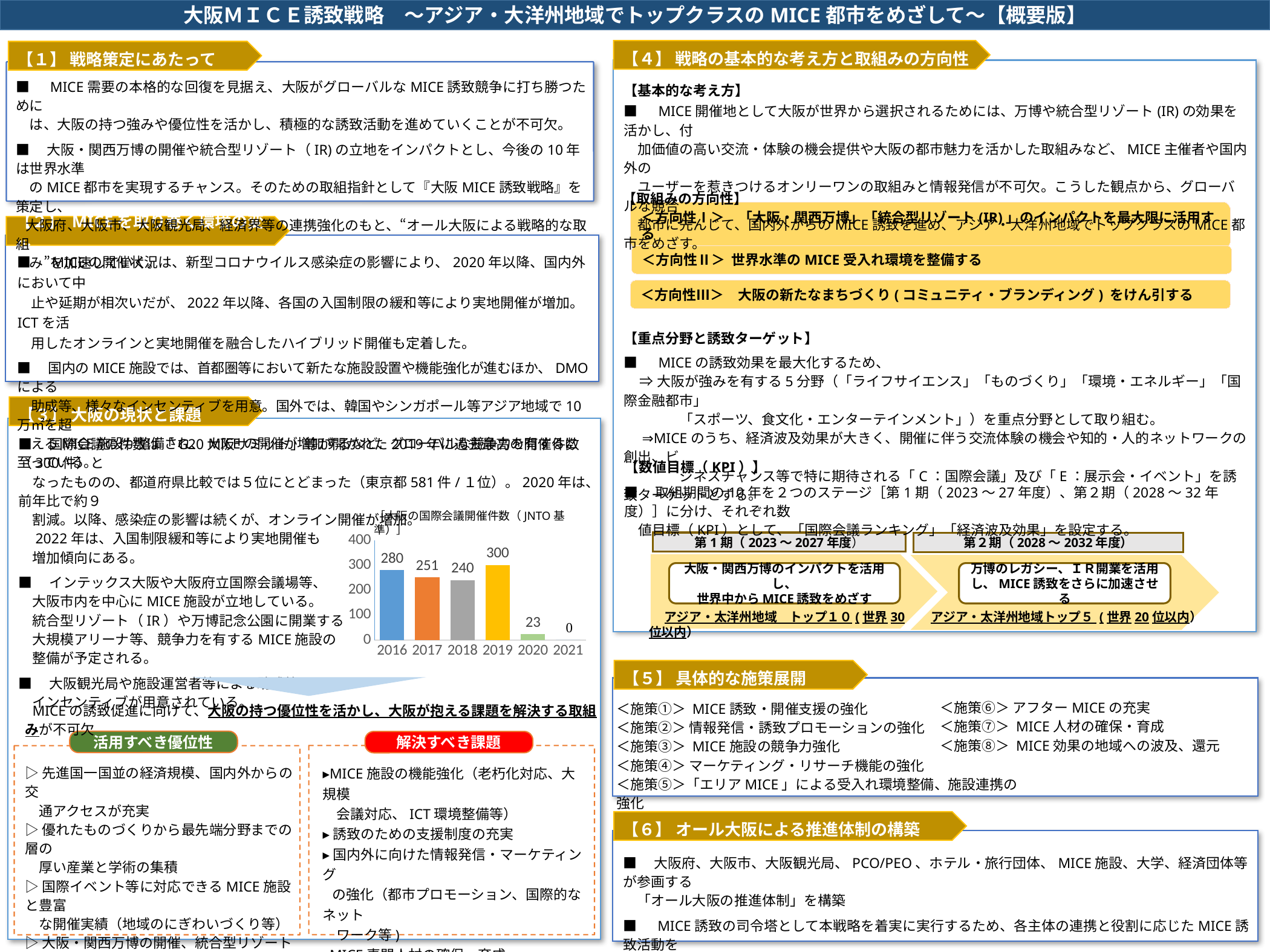
In the chart of 大阪の国際会議開催件数, what is the value for 2019? 300 In the chart of 大阪の国際会議開催件数, which year has the lowest value? 2021 In the chart of 大阪の国際会議開催件数, which is larger, the value for 2017 or the value for 2018? 2017 In the chart of 大阪の国際会議開催件数, is the value for 2017 greater or less than 200? greater In the chart of 大阪の国際会議開催件数, which year has the highest value? 2019 In the chart of 大阪の国際会議開催件数, what is the value for 2018? 240 In the chart of 大阪の国際会議開催件数, what is the value for 2020? 23 In the chart of 大阪の国際会議開催件数, what is the value for 2016? 280 In the chart of 大阪の国際会議開催件数, what is the difference between the values for 2019 and 2020? 277 How many years are shown on the x axis of the chart of 大阪の国際会議開催件数? 6 In the chart of 大阪の国際会議開催件数, do the values rise or fall from 2019 to 2021? fall What type of chart is used to show 大阪の国際会議開催件数? bar chart